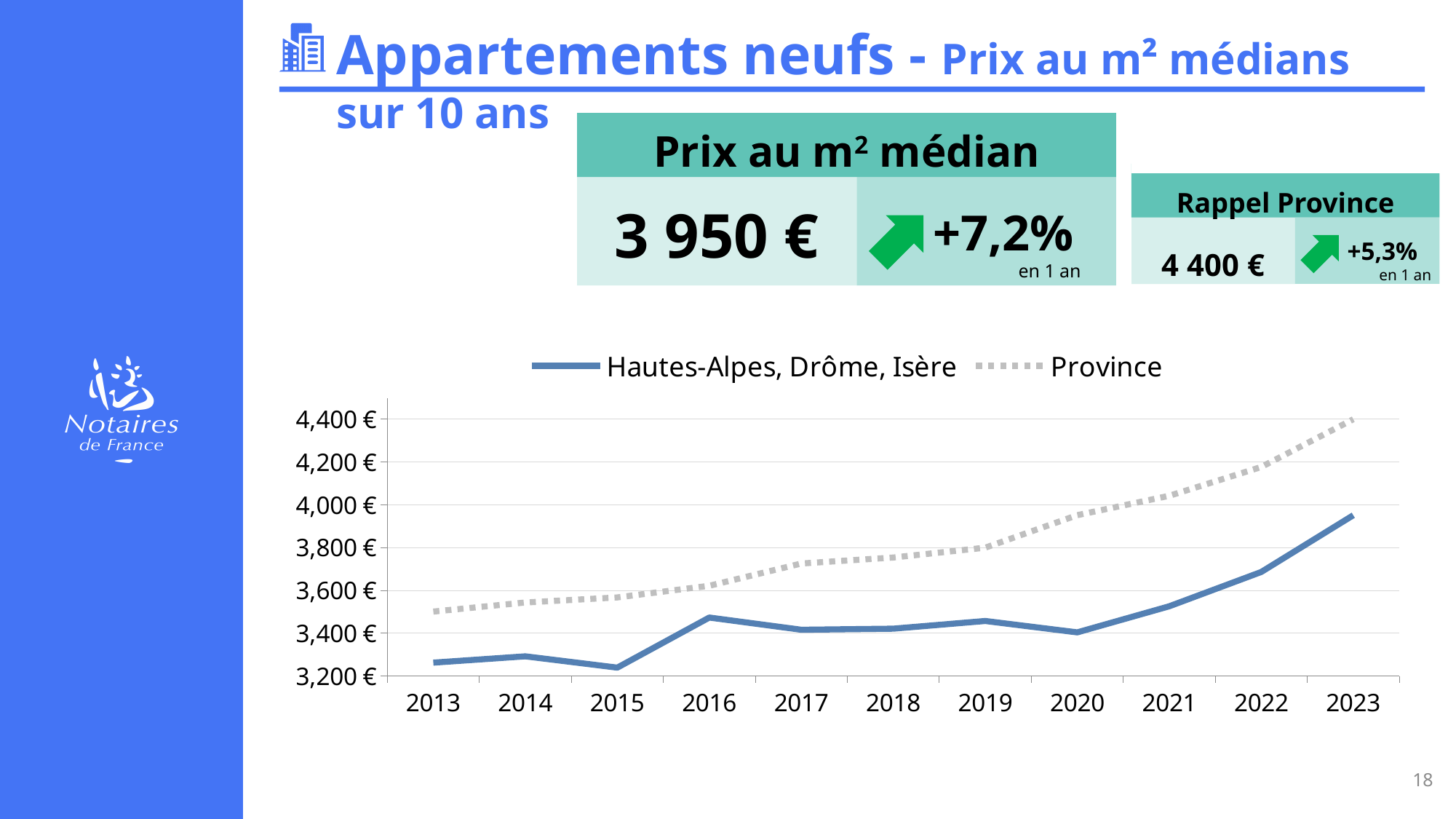
Is the value for Province in 2013 greater or less than 3,400 €? greater Is the value for Hautes-Alpes, Drôme, Isère in 2016 greater or less than 3,600 €? less What kind of chart is shown on the slide? line chart Is the value for Province in 2023 greater or less than 4,200 €? greater In which year does the Hautes-Alpes, Drôme, Isère series reach its highest value? 2023 Which two series are listed in the chart legend? Hautes-Alpes, Drôme, Isère and Province Does the Province line rise or fall from 2013 to 2023? rises How many years are plotted along the x axis of the chart? 11 In 2020, which series has the higher value: Hautes-Alpes, Drôme, Isère or Province? Province How many series does the chart legend list? 2 What is the median price per m² for Hautes-Alpes, Drôme, Isère in 2023, as shown on the slide? 3 950 €